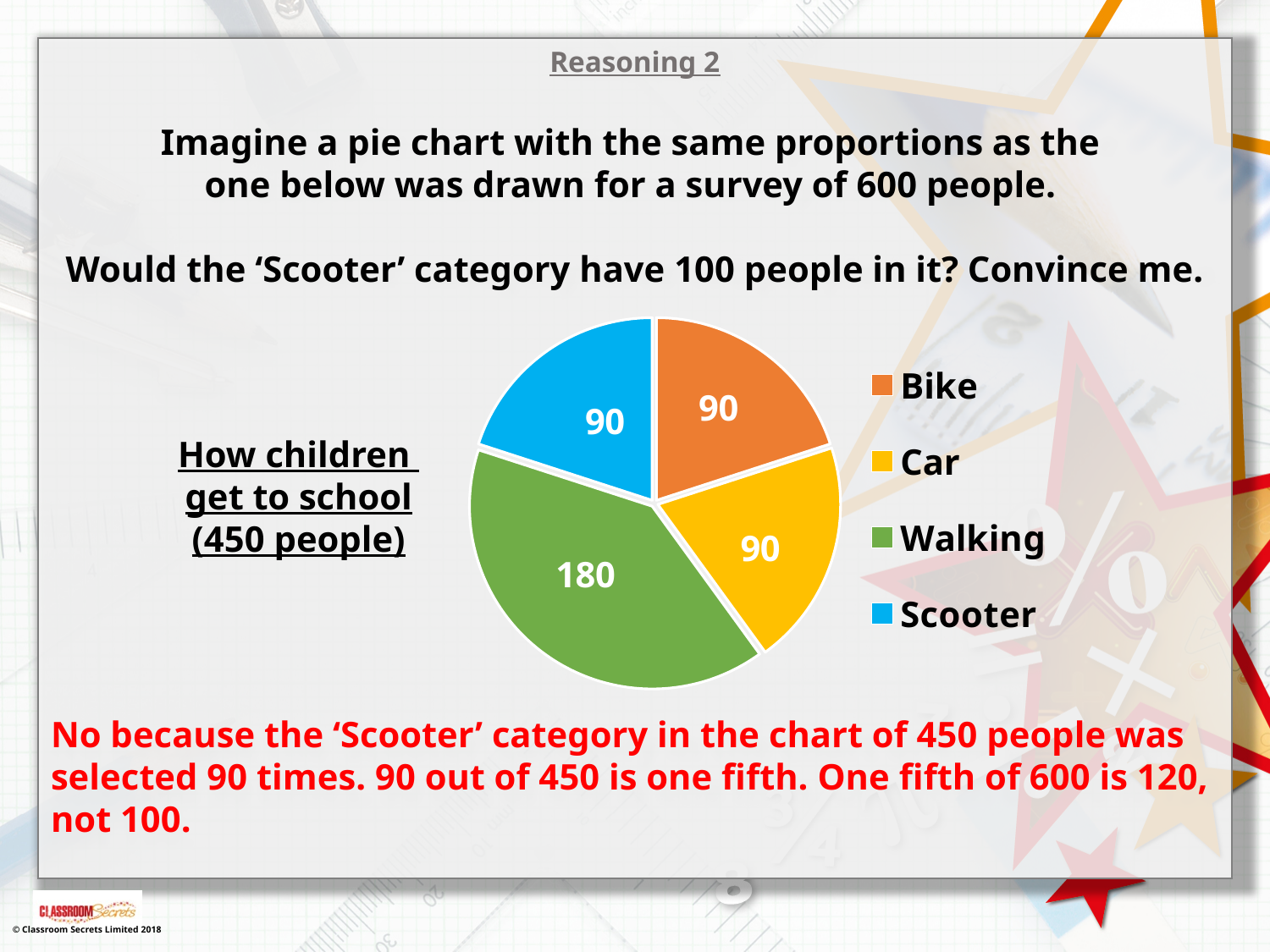
How many categories does the pie chart show? 4 What is the value for Walking in the pie chart? 180 What is the total of all the slices in the pie chart? 450 What share of the pie chart does Walking represent? 40% Which is larger, the value for Walking or the value for Bike? Walking What kind of chart is shown on the slide? pie chart What share of the pie chart does Scooter represent? 20% What is the difference between the values for Walking and Car? 90 What colour is the Scooter slice in the pie chart? blue Which category has the largest slice of the pie chart? Walking What is the value for Bike in the pie chart? 90 What is the value for Scooter in the pie chart? 90